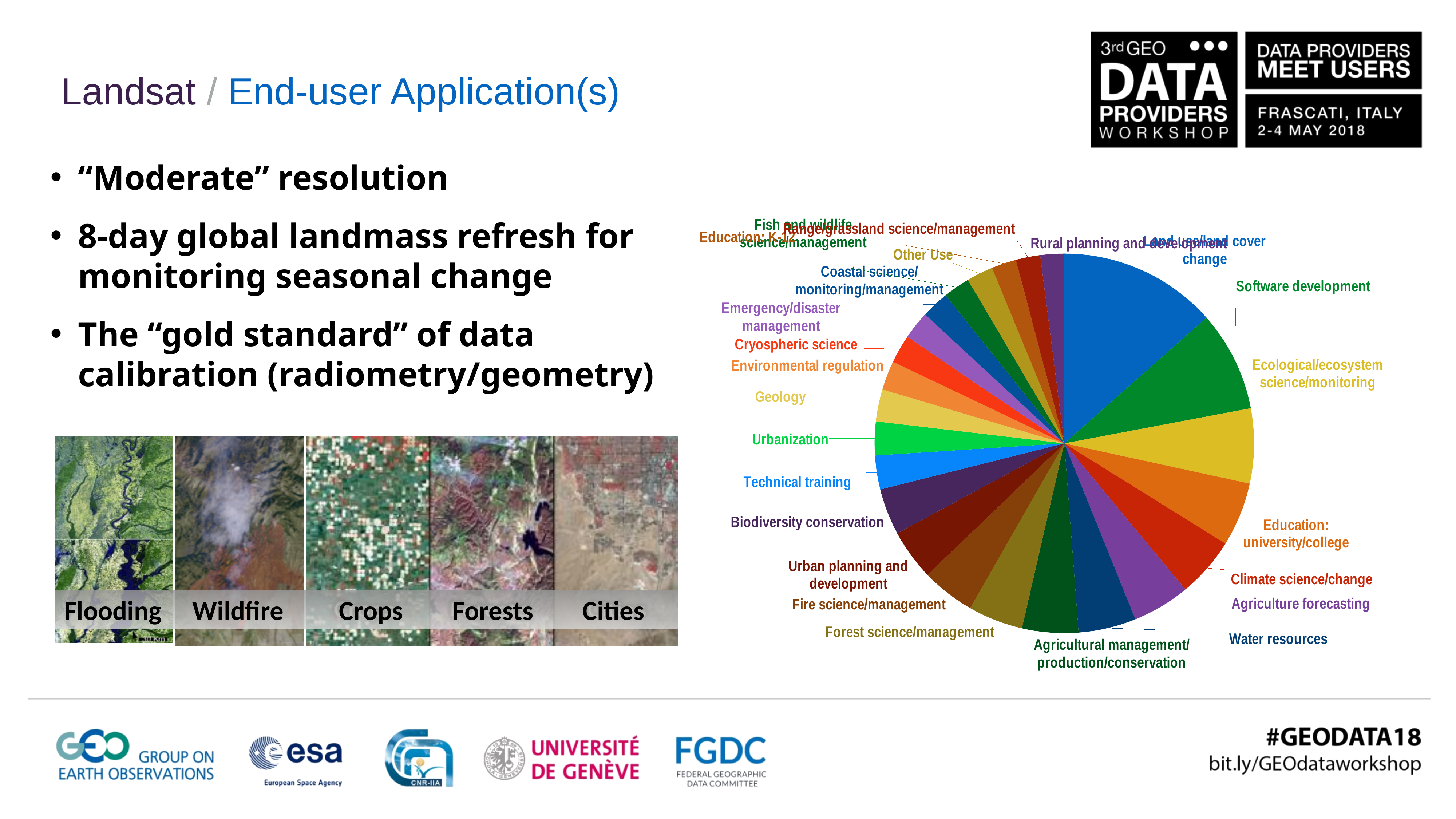
In the pie chart, which slice is larger: Land use/land cover change or Water resources? Land use/land cover change In the pie chart, which slice is larger: Agricultural management/production/conservation or Other Use? Agricultural management/production/conservation In the pie chart, which slice is larger: Forest science/management or Cryospheric science? Forest science/management What kind of chart is shown on the right side of the slide? pie chart Which category has the largest slice in the pie chart? Land use/land cover change What colour is the Software development slice in the pie chart? green What colour is the Land use/land cover change slice in the pie chart? blue